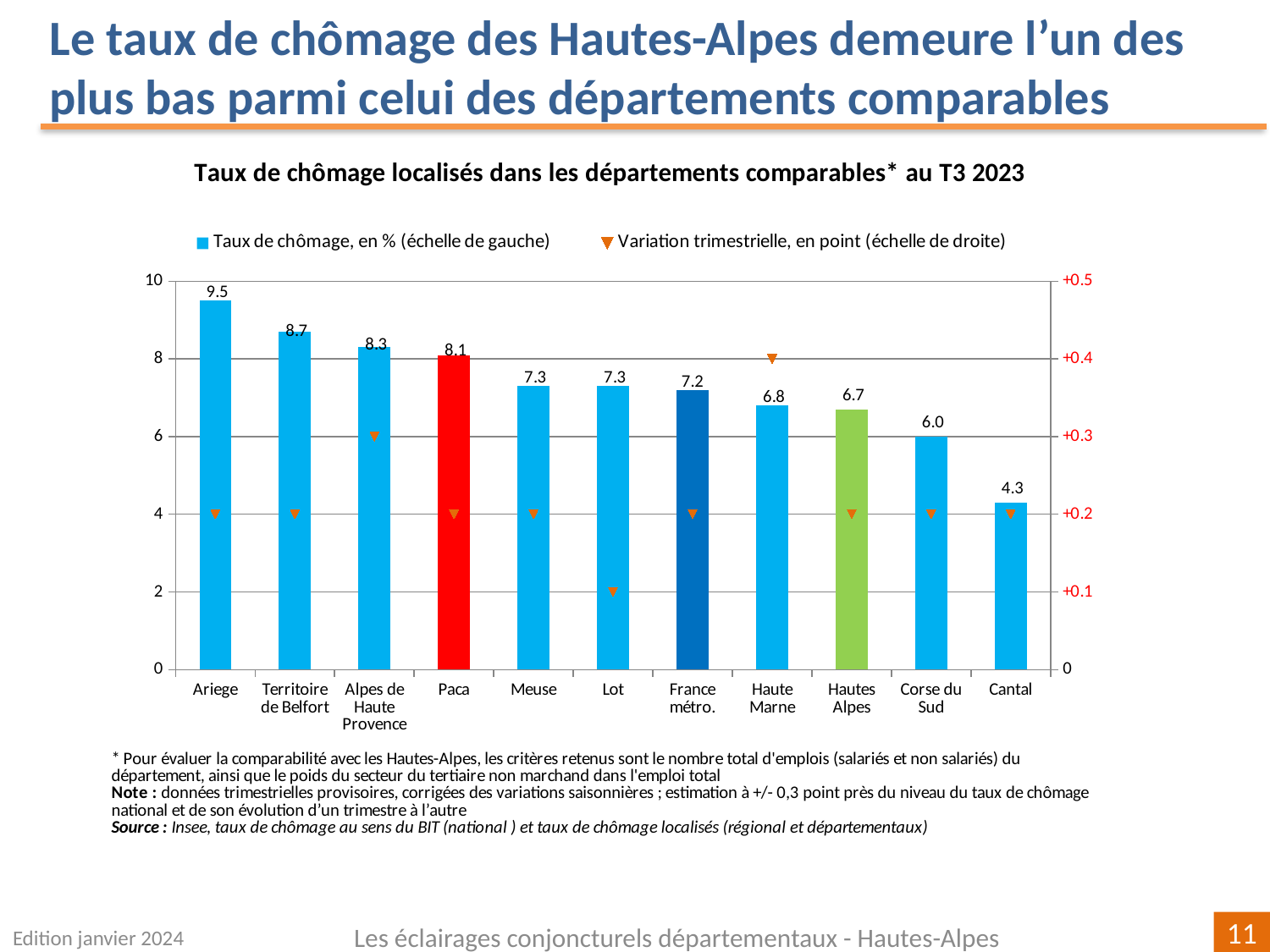
What is the unemployment rate (taux de chômage) shown for Ariege? 9.5 What is the quarterly variation shown for Lot, on the right-hand scale? +0.1 What is the difference between the unemployment rates of Ariege and Cantal? 5.2 What is the unemployment rate shown for Hautes Alpes? 6.7 Which has a higher unemployment rate, Paca or Meuse? Paca Which department has the highest unemployment rate on the chart? Ariege What type of chart is used to show the unemployment rates? Bar chart What is the quarterly variation (variation trimestrielle) shown for Haute Marne, on the right-hand scale? +0.4 How many series does the chart legend list? 2 Which department has the lowest unemployment rate on the chart? Cantal What is the unemployment rate shown for Corse du Sud? 6.0 How many departments or areas are shown on the x axis of the chart? 11